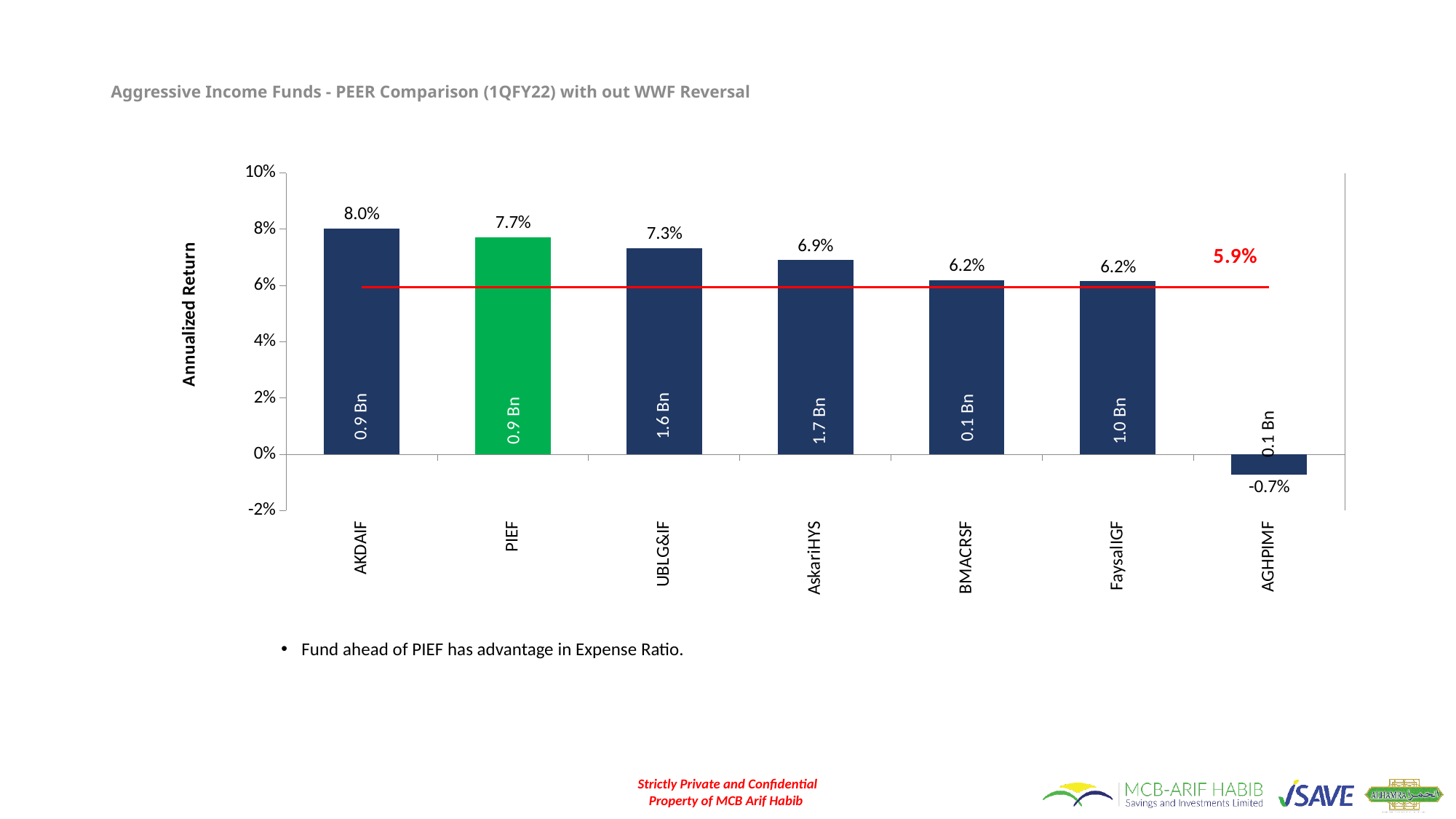
What is the annualized return for AKDAIF? 8.0% What is the difference in annualized return between AKDAIF and PIEF? 0.3% Which has a higher annualized return, UBLG&IF or AskariHYS? UBLG&IF How many funds are shown on the chart? 7 Is the annualized return for BMACRSF greater or less than 6%? greater Which fund has the lowest annualized return? AGHPIMF What is the annualized return for PIEF? 7.7% What value is marked by the red horizontal line on the chart? 5.9% What fund size label is shown inside the AskariHYS bar? 1.7 Bn Which fund has the highest annualized return? AKDAIF What is the annualized return for AGHPIMF? -0.7% What kind of chart is shown on the slide? Bar chart